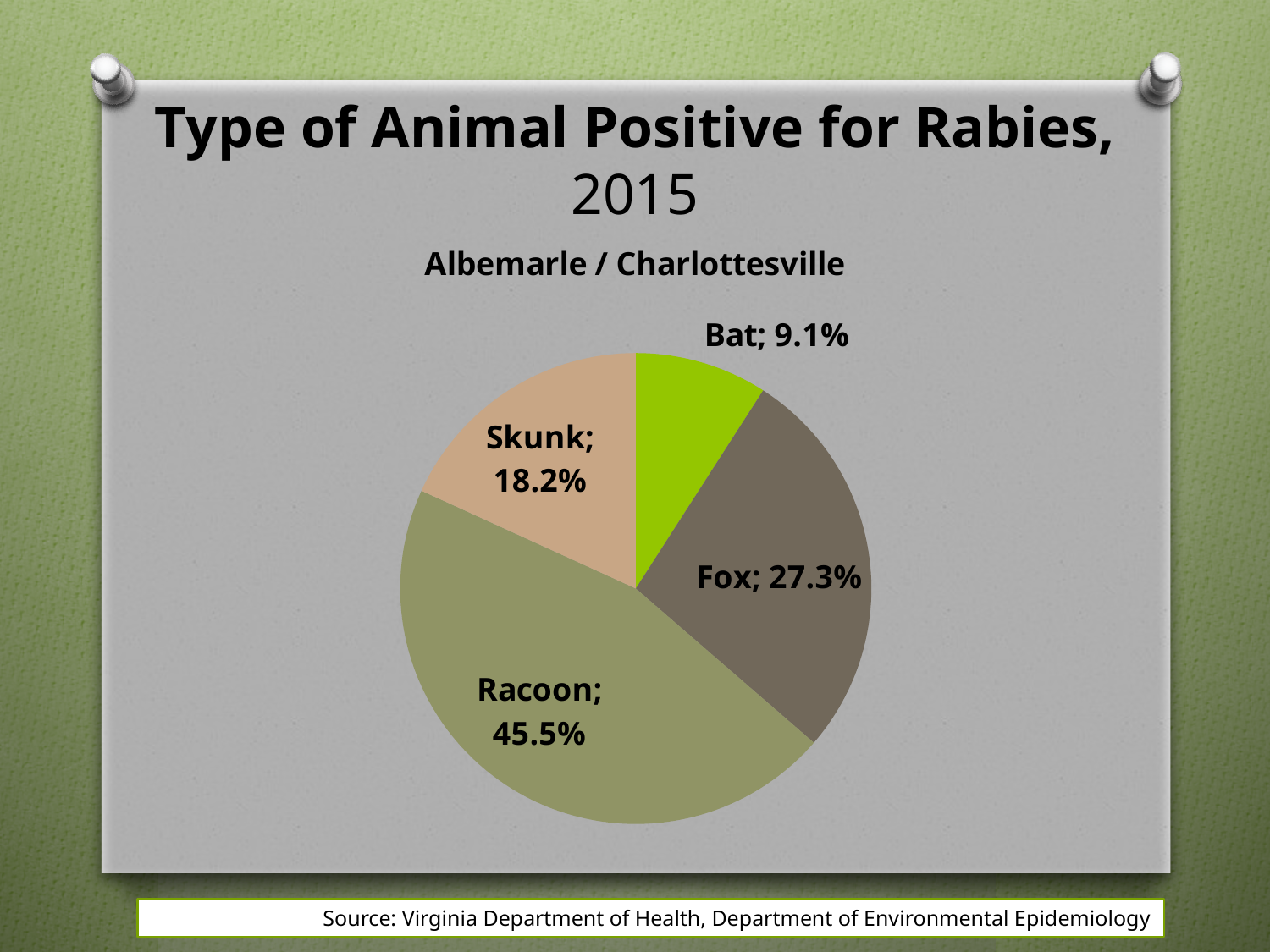
Which animal has the smallest slice of the pie? Bat What is the title of the chart? Albemarle / Charlottesville What is the difference in percentage points between Skunk and Bat? 9.1 What share of the pie does Racoon account for? 45.5% What is the value shown for Skunk? 18.2% Which is larger, the share for Fox or the share for Skunk? Fox What type of chart is shown on the slide? Pie chart How many animal categories are shown in the pie chart? 4 What is the value shown for Fox? 27.3% What is the difference in percentage points between Racoon and Fox? 18.2 What is the value shown for Bat? 9.1% Which animal has the largest slice of the pie? Racoon